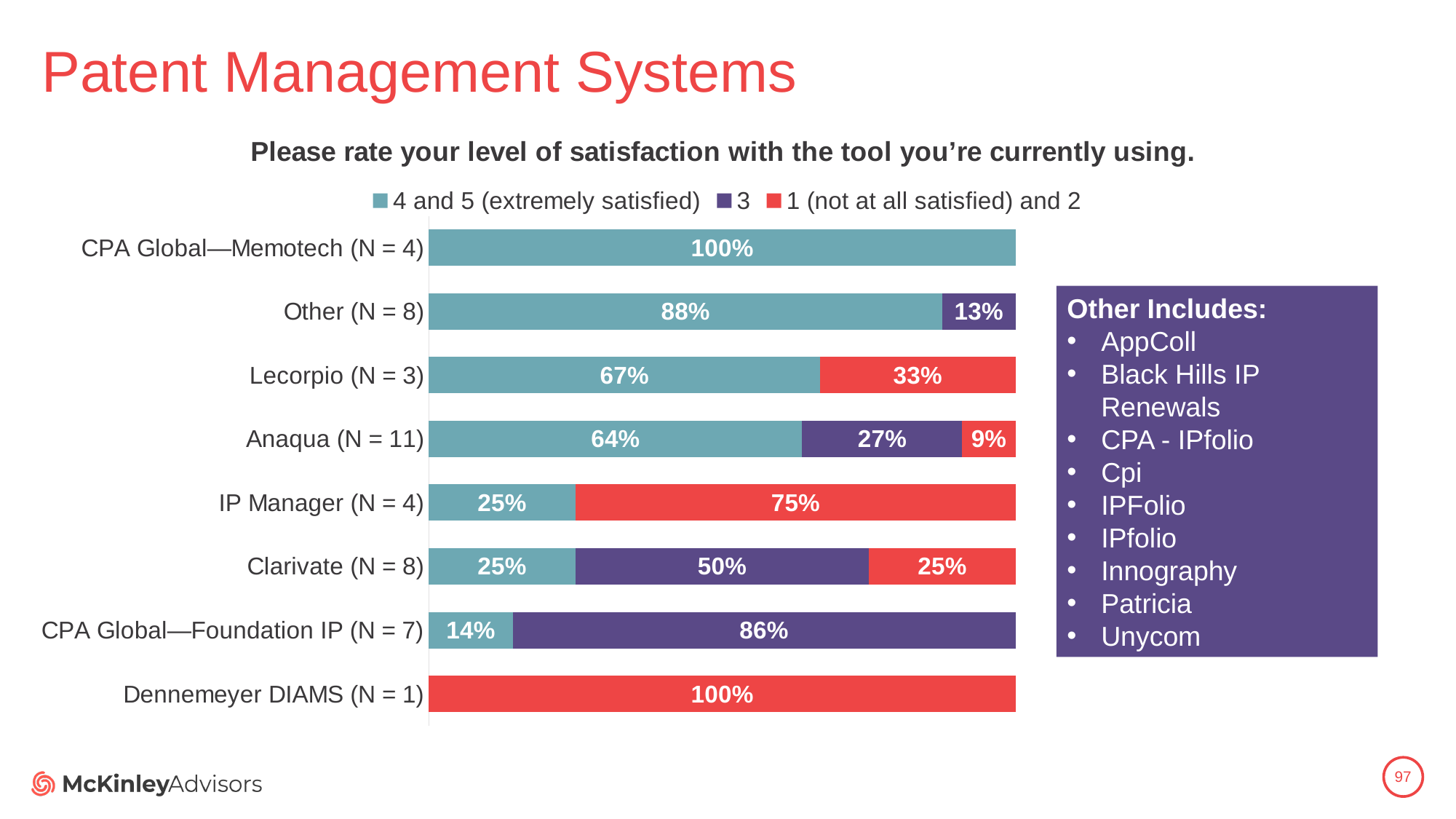
Which colour represents the 1 (not at all satisfied) and 2 rating in the chart? Red Which tool has the highest share of respondents rating 1 (not at all satisfied) and 2? Dennemeyer DIAMS (N = 1) Which tool has the highest share of respondents rating 4 and 5 (extremely satisfied)? CPA Global—Memotech (N = 4) What kind of chart is shown on the slide? Stacked bar chart Which has a larger share of respondents rating 3: Anaqua (N = 11) or CPA Global—Foundation IP (N = 7)? CPA Global—Foundation IP (N = 7) How many series does the legend list? 3 What percentage of IP Manager (N = 4) respondents rated their satisfaction 1 (not at all satisfied) and 2? 75% How many tools (categories) are shown in the chart? 8 What is the difference between the 4 and 5 (extremely satisfied) share for Other (N = 8) and for Lecorpio (N = 3)? 21 percentage points What percentage of Anaqua (N = 11) respondents rated their satisfaction 4 and 5 (extremely satisfied)? 64% What percentage of Clarivate (N = 8) respondents gave a rating of 3? 50% What percentage of CPA Global—Foundation IP (N = 7) respondents rated their satisfaction 4 and 5 (extremely satisfied)? 14%